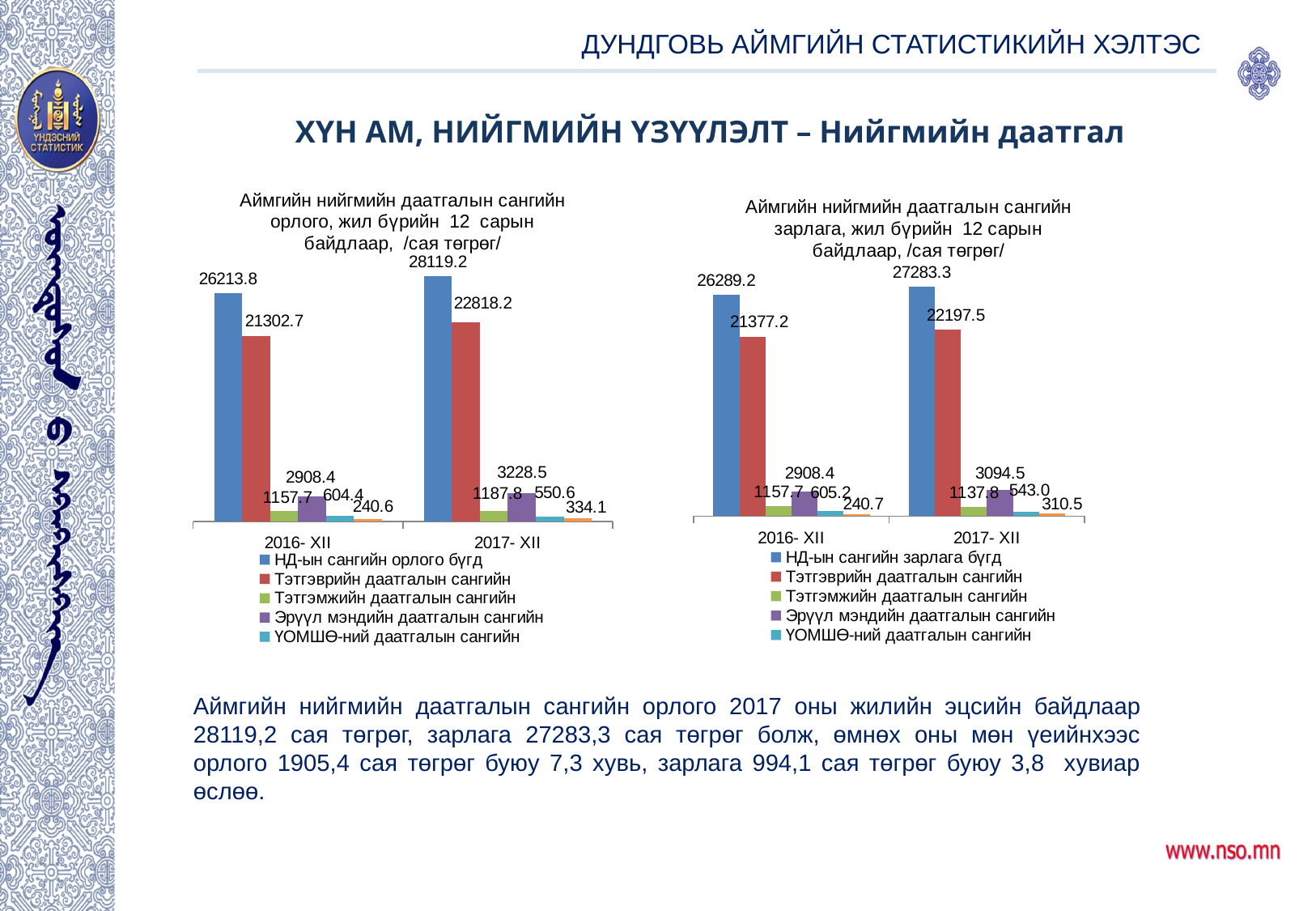
In the left chart, which series has the lowest value in 2017- XII among the legend entries? ҮОМШӨ-ний даатгалын сангийн In the left chart, what is the difference between НД-ын сангийн орлого бүгд in 2017- XII and in 2016- XII? 1905.4 In the right chart (Аймгийн нийгмийн даатгалын сангийн зарлага), what is the value of НД-ын сангийн зарлага бүгд for 2016- XII? 26289.2 In the right chart, which series has the highest value in 2017- XII? НД-ын сангийн зарлага бүгд In the right chart, what is the value of Эрүүл мэндийн даатгалын сангийн for 2017- XII? 3094.5 In the left chart, what is the value of Тэтгэврийн даатгалын сангийн for 2016- XII? 21302.7 In the right chart, what is the difference between НД-ын сангийн зарлага бүгд in 2017- XII and in 2016- XII? 994.1 In the left chart (Аймгийн нийгмийн даатгалын сангийн орлого), what is the value of НД-ын сангийн орлого бүгд for 2017- XII? 28119.2 How many series does the legend of the right chart list? 5 In the left chart, which is larger: Тэтгэмжийн даатгалын сангийн in 2016- XII or in 2017- XII? 2017- XII What type of chart is the left chart? Bar chart How many categories are shown on the x axis of the left chart? 2